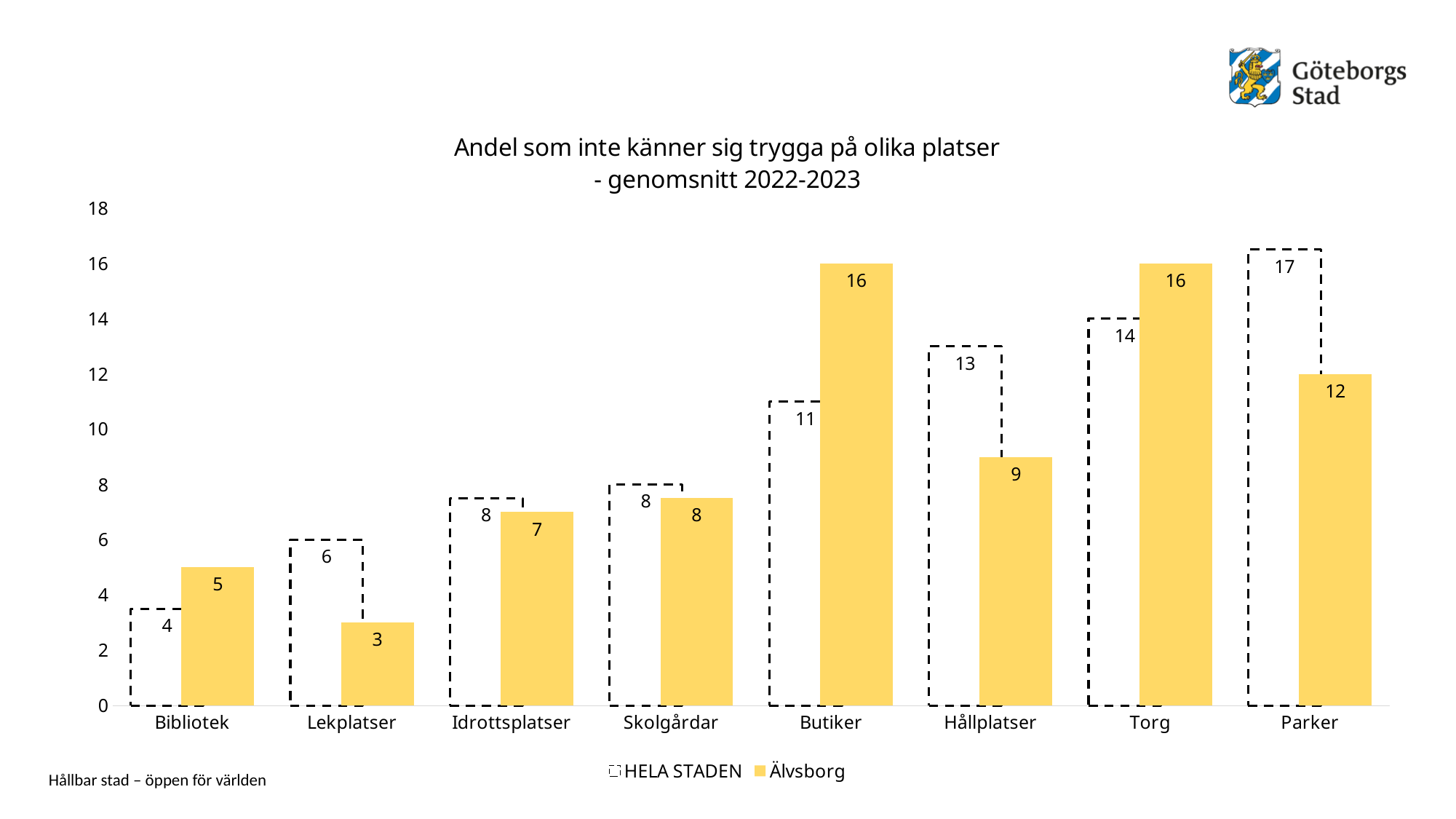
What is the title of the chart? Andel som inte känner sig trygga på olika platser - genomsnitt 2022-2023 Which category has the lowest value for Älvsborg? Lekplatser What is the value for HELA STADEN at Hållplatser? 13 How many categories are shown on the x axis? 8 How many series does the legend list? 2 What is the value for Älvsborg at Lekplatser? 3 Is the value for Älvsborg at Torg greater or less than 10? greater What type of chart is shown on the slide? bar chart What is the value for Älvsborg at Butiker? 16 Which category has the highest value for HELA STADEN? Parker What is the difference between the Älvsborg and HELA STADEN values at Butiker? 5 Which is larger at Parker, the HELA STADEN value or the Älvsborg value? HELA STADEN